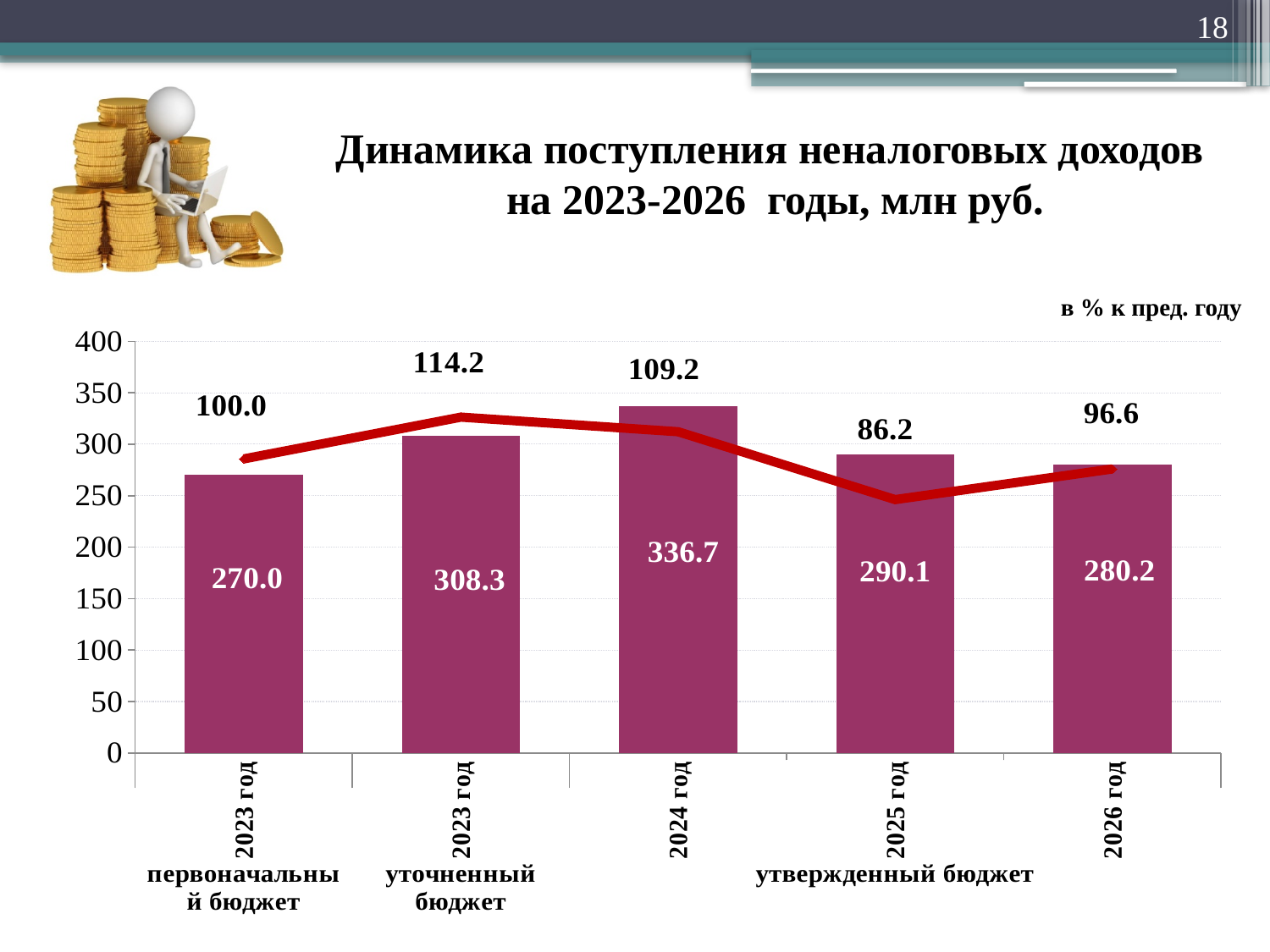
What is the title of the chart? Динамика поступления неналоговых доходов на 2023-2026 годы, млн руб. What kind of chart is shown on the slide? Bar chart with a line Which is larger, the bar value for 2025 год or for 2026 год? 2025 год Which year has the highest bar value? 2024 год How many bars are plotted in the chart? 5 Is the bar value for 2023 год (первоначальный бюджет) greater or less than 300? less What is the value of the bar for 2023 год (уточненный бюджет)? 308.3 Which category has the lowest bar value? 2023 год (первоначальный бюджет) What percentage to the previous year is shown for 2026 год? 96.6 What percentage to the previous year (в % к пред. году) is shown for 2025 год? 86.2 What is the non-tax revenue value shown for 2024 год? 336.7 What is the difference between the bar values for 2024 год and 2025 год? 46.6